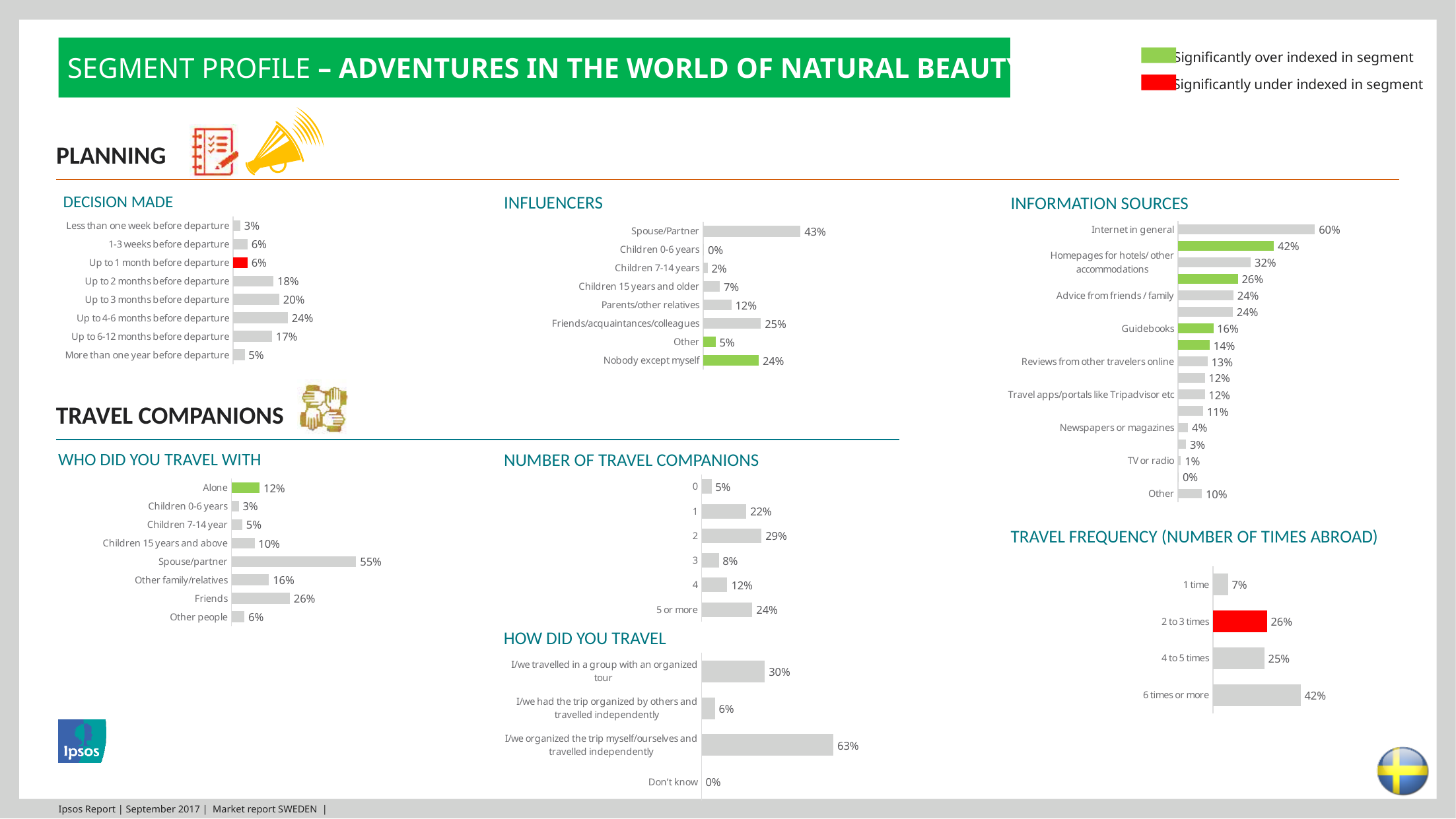
In the WHO DID YOU TRAVEL WITH chart, which is larger, 'Friends' or 'Other family/relatives'? Friends In the INFLUENCERS chart, what is the difference between 'Friends/acquaintances/colleagues' and 'Parents/other relatives'? 13% In the DECISION MADE chart, what is the value for 'Up to 4-6 months before departure'? 24% What type of chart is the TRAVEL FREQUENCY (NUMBER OF TIMES ABROAD) chart? Bar chart In the TRAVEL FREQUENCY (NUMBER OF TIMES ABROAD) chart, what is the difference between '6 times or more' and '1 time'? 35% In the HOW DID YOU TRAVEL chart, what is the value for 'I/we organized the trip myself/ourselves and travelled independently'? 63% In the INFLUENCERS chart, which category has the highest value? Spouse/Partner In the DECISION MADE chart, which category has the lowest value? Less than one week before departure In the NUMBER OF TRAVEL COMPANIONS chart, which category has the highest value? 2 In the INFORMATION SOURCES chart, what is the value for 'Internet in general'? 60% How many categories does the WHO DID YOU TRAVEL WITH chart show? 8 In the NUMBER OF TRAVEL COMPANIONS chart, what is the value for '5 or more'? 24%